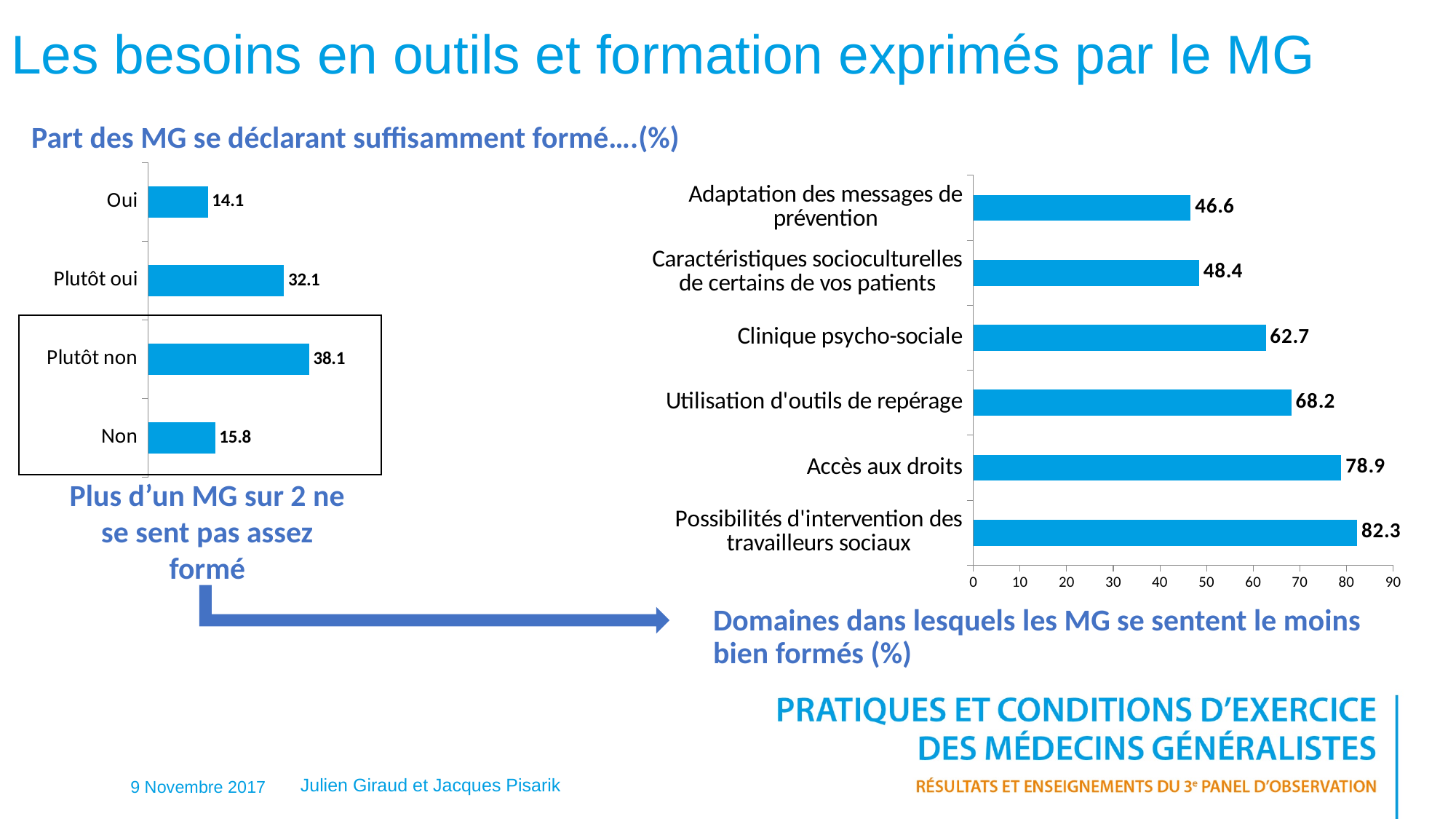
In the right chart (Domaines dans lesquels les MG se sentent le moins bien formés), is the value for "Clinique psycho-sociale" greater or less than 60? greater In the left chart (Part des MG se déclarant suffisamment formé), which category has the lowest value? Oui In the left chart (Part des MG se déclarant suffisamment formé), what is the difference between "Plutôt non" and "Plutôt oui"? 6.0 In the right chart (Domaines dans lesquels les MG se sentent le moins bien formés), which domain has the highest value? Possibilités d'intervention des travailleurs sociaux What type of chart is the right chart (Domaines dans lesquels les MG se sentent le moins bien formés)? Bar chart In the right chart (Domaines dans lesquels les MG se sentent le moins bien formés), what is the difference between "Utilisation d'outils de repérage" and "Clinique psycho-sociale"? 5.5 In the left chart (Part des MG se déclarant suffisamment formé), how many categories are shown? 4 In the left chart (Part des MG se déclarant suffisamment formé), which is larger: "Non" or "Oui"? Non In the right chart (Domaines dans lesquels les MG se sentent le moins bien formés), which domain has the lowest value? Adaptation des messages de prévention In the right chart (Domaines dans lesquels les MG se sentent le moins bien formés), how many domains are listed? 6 In the right chart (Domaines dans lesquels les MG se sentent le moins bien formés), what is the value for "Accès aux droits"? 78.9 In the left chart (Part des MG se déclarant suffisamment formé), what is the value for "Plutôt non"? 38.1